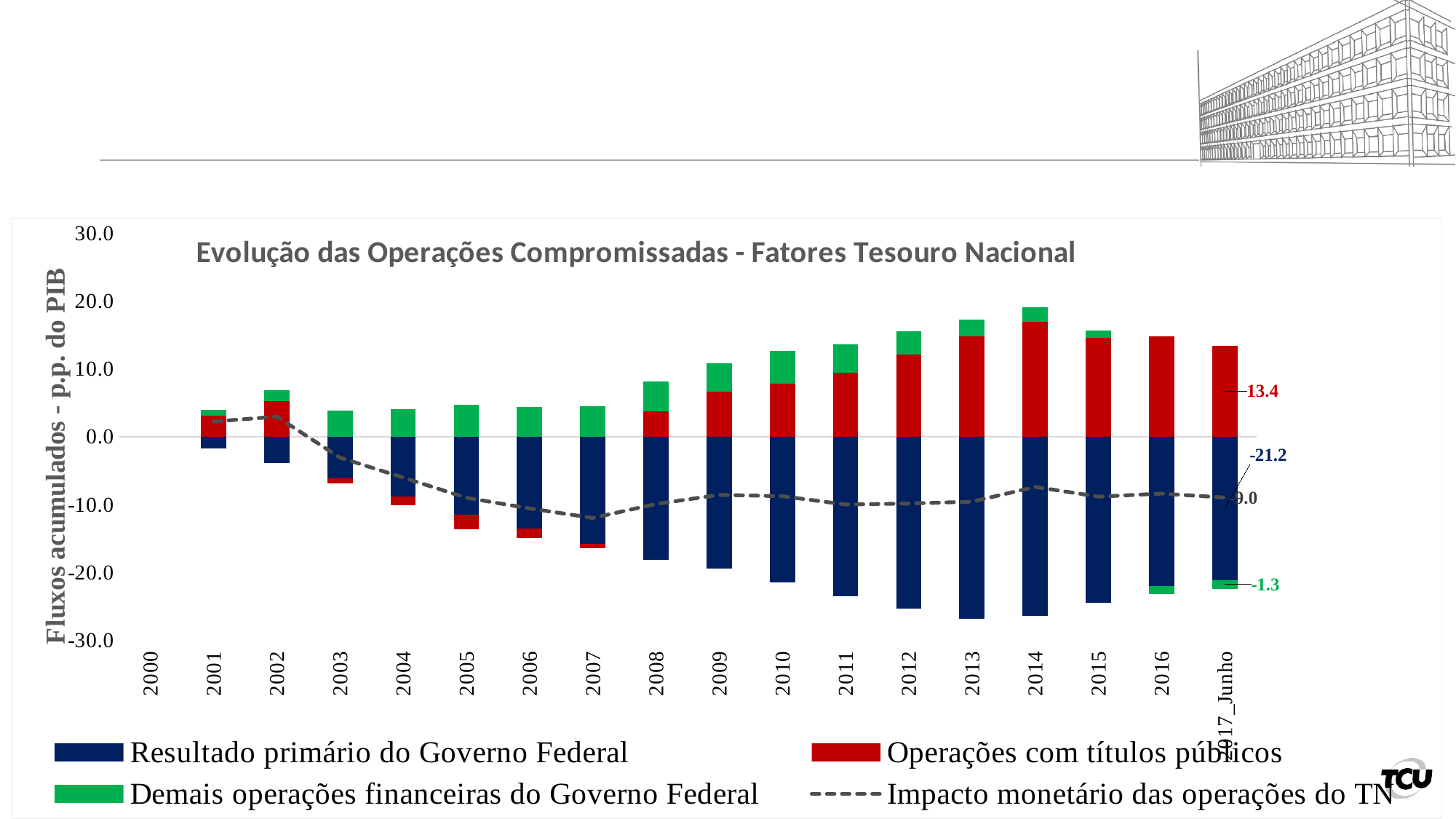
What is the value of 'Impacto monetário das operações do TN' for 2017_Junho? -9.0 What is the title of the chart? Evolução das Operações Compromissadas - Fatores Tesouro Nacional What kind of chart is this? Stacked bar chart with a line What is the value of 'Demais operações financeiras do Governo Federal' for 2017_Junho? -1.3 How many series does the legend list? 4 Does the 'Operações com títulos públicos' segment rise or fall from 2008 to 2014? Rise Is the value of 'Operações com títulos públicos' for 2014 greater or less than 10.0? greater How many categories are shown on the x axis? 18 Is the value of 'Resultado primário do Governo Federal' for 2013 greater or less than -20.0? less What is the value of 'Resultado primário do Governo Federal' for 2017_Junho? -21.2 What is the value of 'Operações com títulos públicos' for 2017_Junho? 13.4 In which year is the 'Operações com títulos públicos' segment the largest? 2014